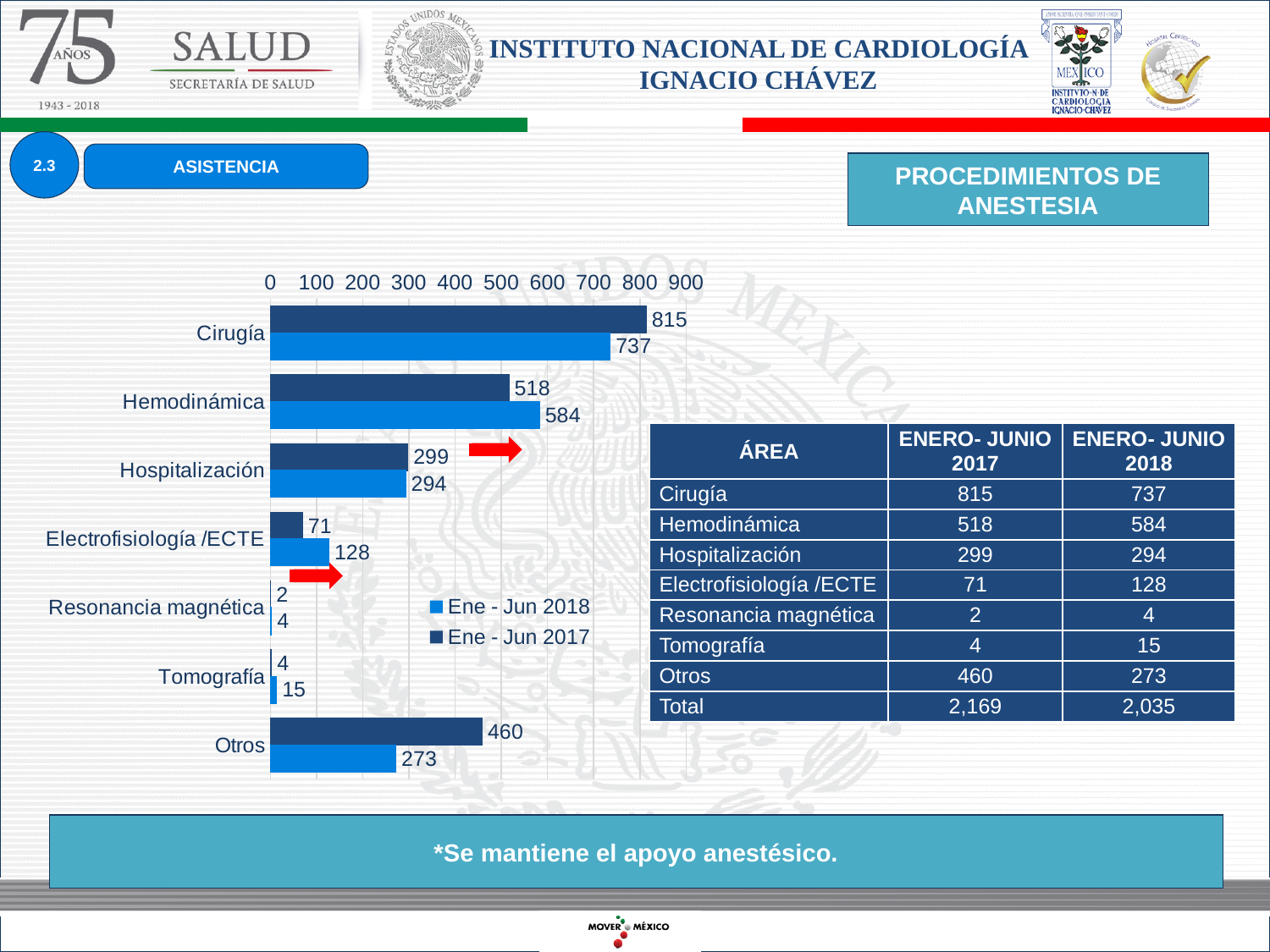
What is the difference between the Ene - Jun 2017 and Ene - Jun 2018 values for Otros? 187 How many categories are plotted on the chart? 7 What is the value for Hemodinámica in the Ene - Jun 2018 series? 584 How many series does the chart legend list? 2 Which category has the highest value in the Ene - Jun 2018 series? Cirugía Which category has the lowest value in the Ene - Jun 2017 series? Resonancia magnética What is the value for Cirugía in the Ene - Jun 2017 series? 815 Which colour represents the Ene - Jun 2017 series in the chart? dark blue For Hemodinámica, which series has the larger value, Ene - Jun 2017 or Ene - Jun 2018? Ene - Jun 2018 What kind of chart is shown on the slide? bar chart What is the value for Electrofisiología /ECTE in the Ene - Jun 2018 series? 128 Is the Ene - Jun 2018 value for Cirugía greater or less than 700? greater